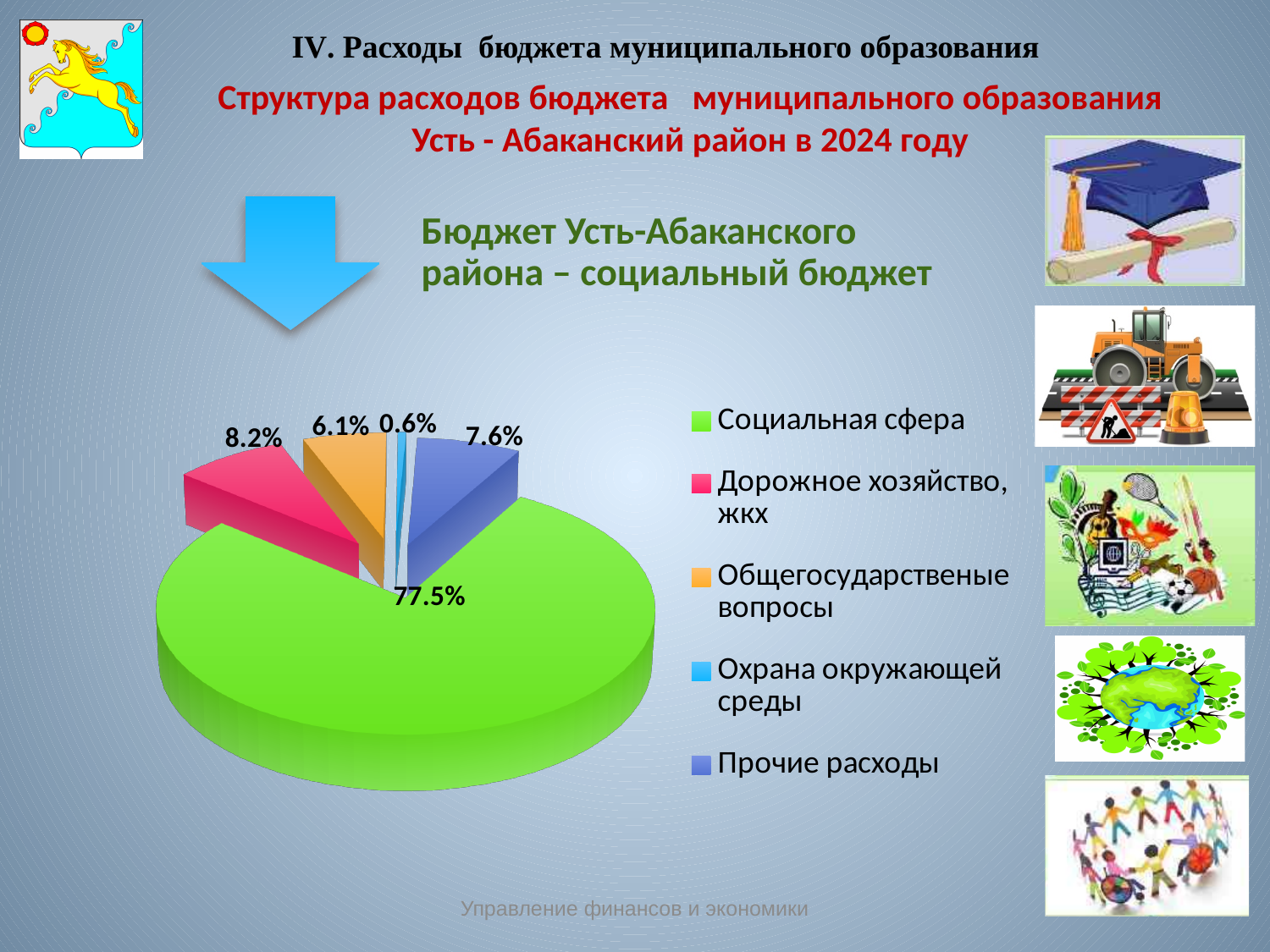
Which category has the largest share of the pie chart? Социальная сфера What percentage is shown for Охрана окружающей среды? 0.6% What percentage is shown for Дорожное хозяйство, жкх? 8.2% What is the difference in percentage points between Дорожное хозяйство, жкх and Прочие расходы? 0.6 How many slices does the pie chart have? 5 What colour is the slice for Социальная сфера? Green Which category has the smallest share of the pie chart? Охрана окружающей среды What percentage is shown for Прочие расходы? 7.6% What percentage is shown for Общегосударственые вопросы? 6.1% What share of the pie chart is labelled for Социальная сфера? 77.5% What type of chart is shown on the slide? Pie chart Which is larger: the share for Дорожное хозяйство, жкх or the share for Общегосударственые вопросы? Дорожное хозяйство, жкх